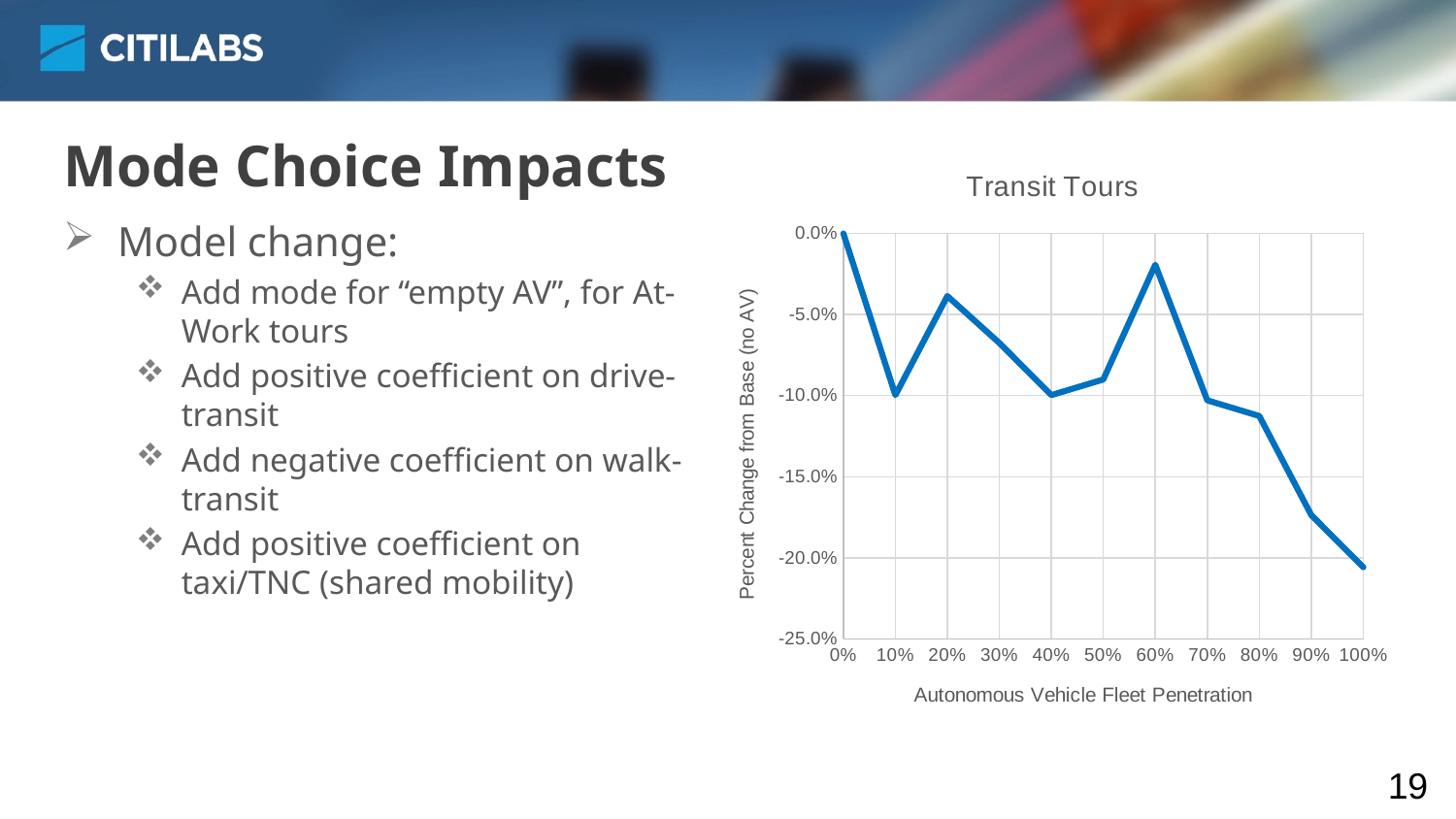
Overall, do the values rise or fall as fleet penetration increases from 0% to 100%? fall What is the percent change from base at 40% autonomous vehicle fleet penetration? -10.0% At which fleet penetration level is the percent change from base the highest? 0% Is the value at 90% fleet penetration greater or less than -15.0%? less What is the title of the chart? Transit Tours At which fleet penetration level is the percent change from base the lowest? 100% What is the label of the x axis of the chart? Autonomous Vehicle Fleet Penetration Is the value at 60% fleet penetration greater or less than -5.0%? greater What type of chart is shown on the slide? line chart What is the percent change from base at 0% autonomous vehicle fleet penetration? 0.0% How many data points are plotted on the line? 11